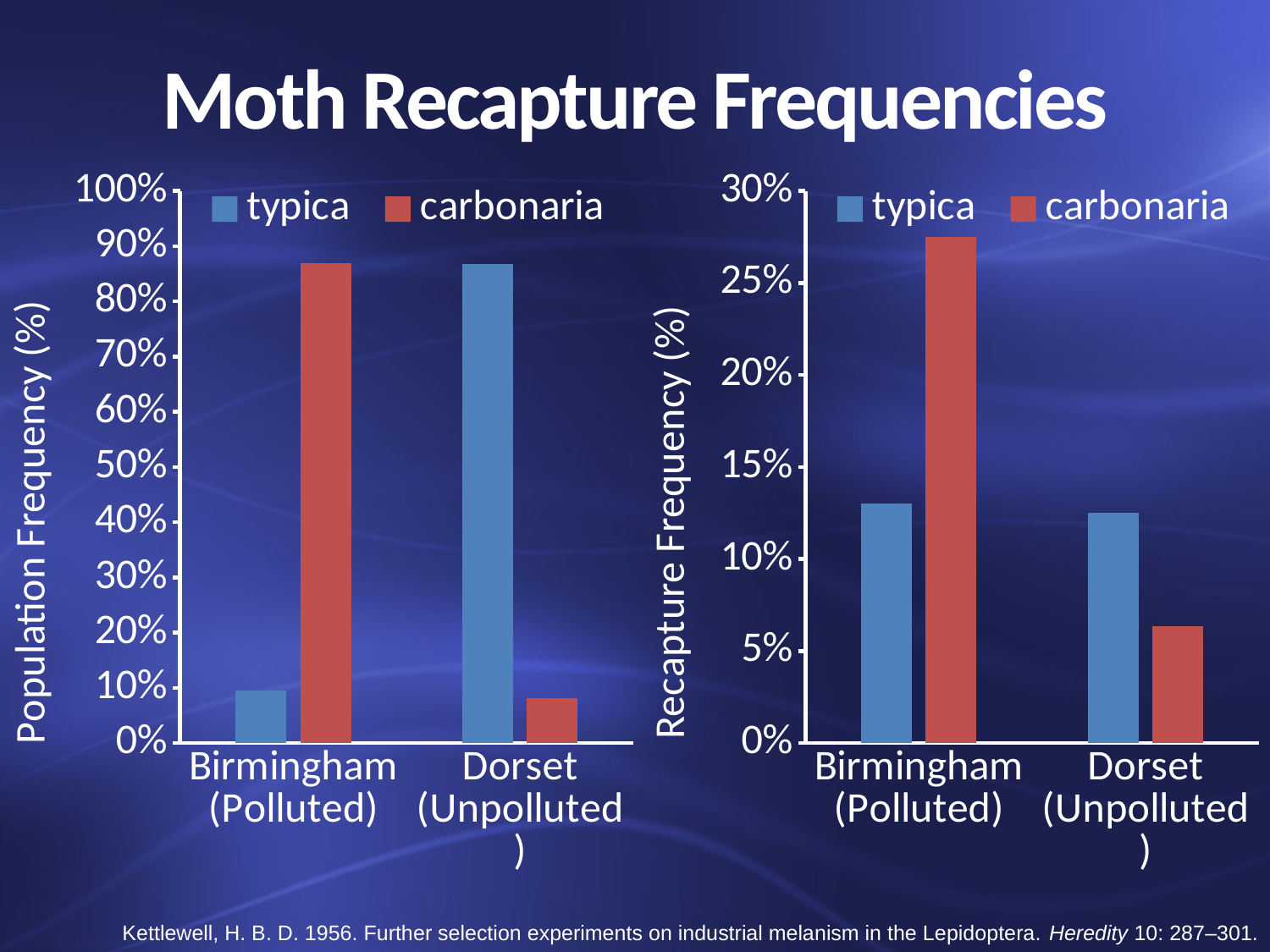
On the left chart (Population Frequency), is the value for typica in Dorset (Unpolluted) greater or less than 80%? greater On the right chart (Recapture Frequency), is the value for carbonaria in Dorset (Unpolluted) greater or less than 10%? less On the left chart (Population Frequency), which series has the larger value in Dorset (Unpolluted), typica or carbonaria? typica On the right chart (Recapture Frequency), which series has the larger value in Dorset (Unpolluted), typica or carbonaria? typica On the right chart (Recapture Frequency), which bar is the highest? carbonaria in Birmingham (Polluted) On the left chart (Population Frequency), which series has the larger value in Birmingham (Polluted), typica or carbonaria? carbonaria On the left chart (Population Frequency), is the value for carbonaria in Birmingham (Polluted) greater or less than 80%? greater What kind of chart is the right chart (Recapture Frequency)? bar chart How many series does the legend of the left chart (Population Frequency) list? 2 On the right chart (Recapture Frequency), which bar is the lowest? carbonaria in Dorset (Unpolluted)